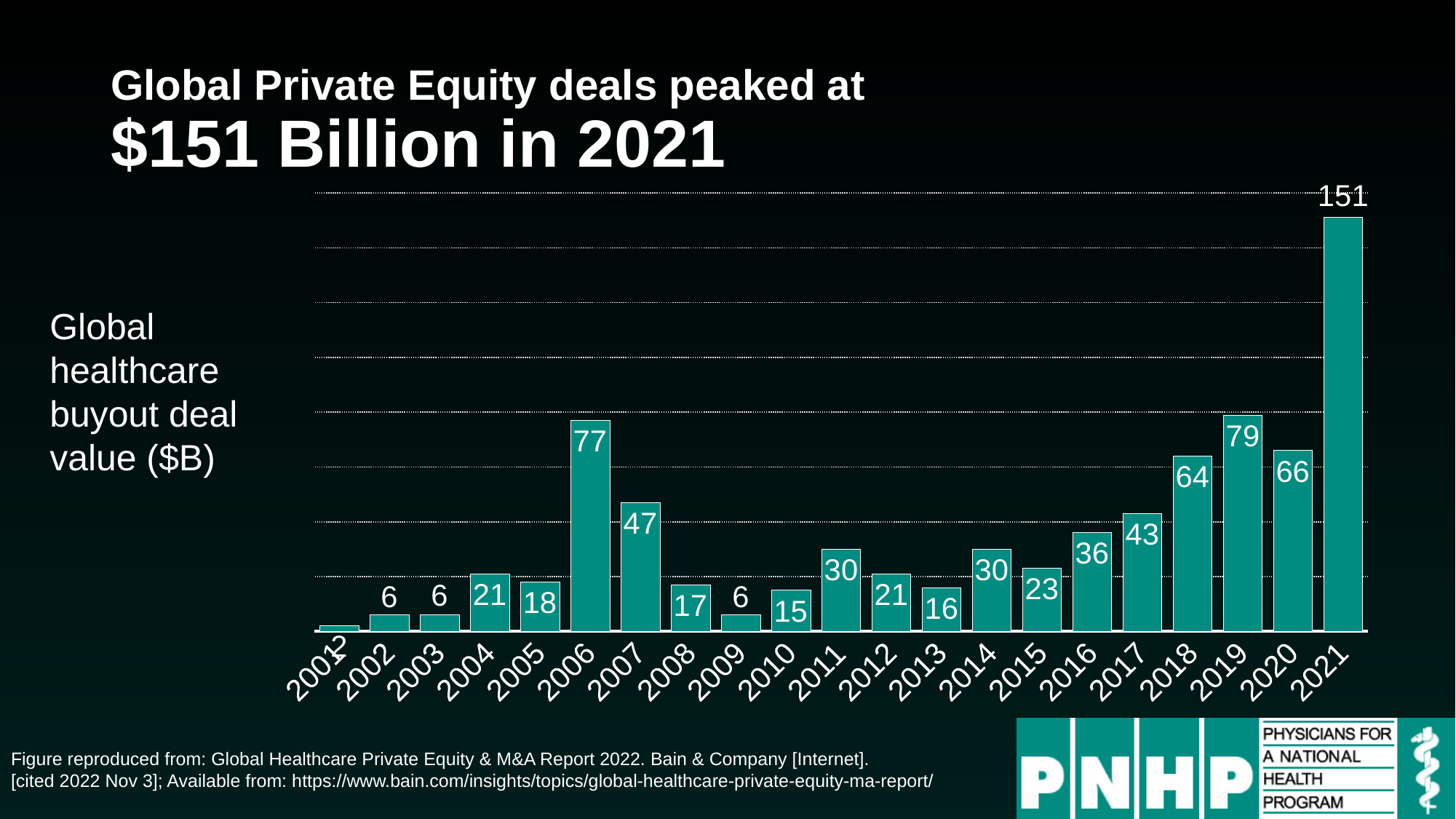
What is the value shown for 2013? 16 Which is larger, the value for 2016 or the value for 2015? 2016 Which year has the highest deal value? 2021 What is the global healthcare buyout deal value for 2021? 151 What is the value shown for 2019? 79 What kind of chart is shown on the slide? Bar chart What is the value shown for 2006? 77 Which is larger, the value for 2018 or the value for 2020? 2020 Do the values rise or fall from 2016 to 2019? Rise What is the difference between the 2006 value and the 2007 value? 30 What is the difference between the 2021 value and the 2020 value? 85 How many years are shown on the x axis? 21